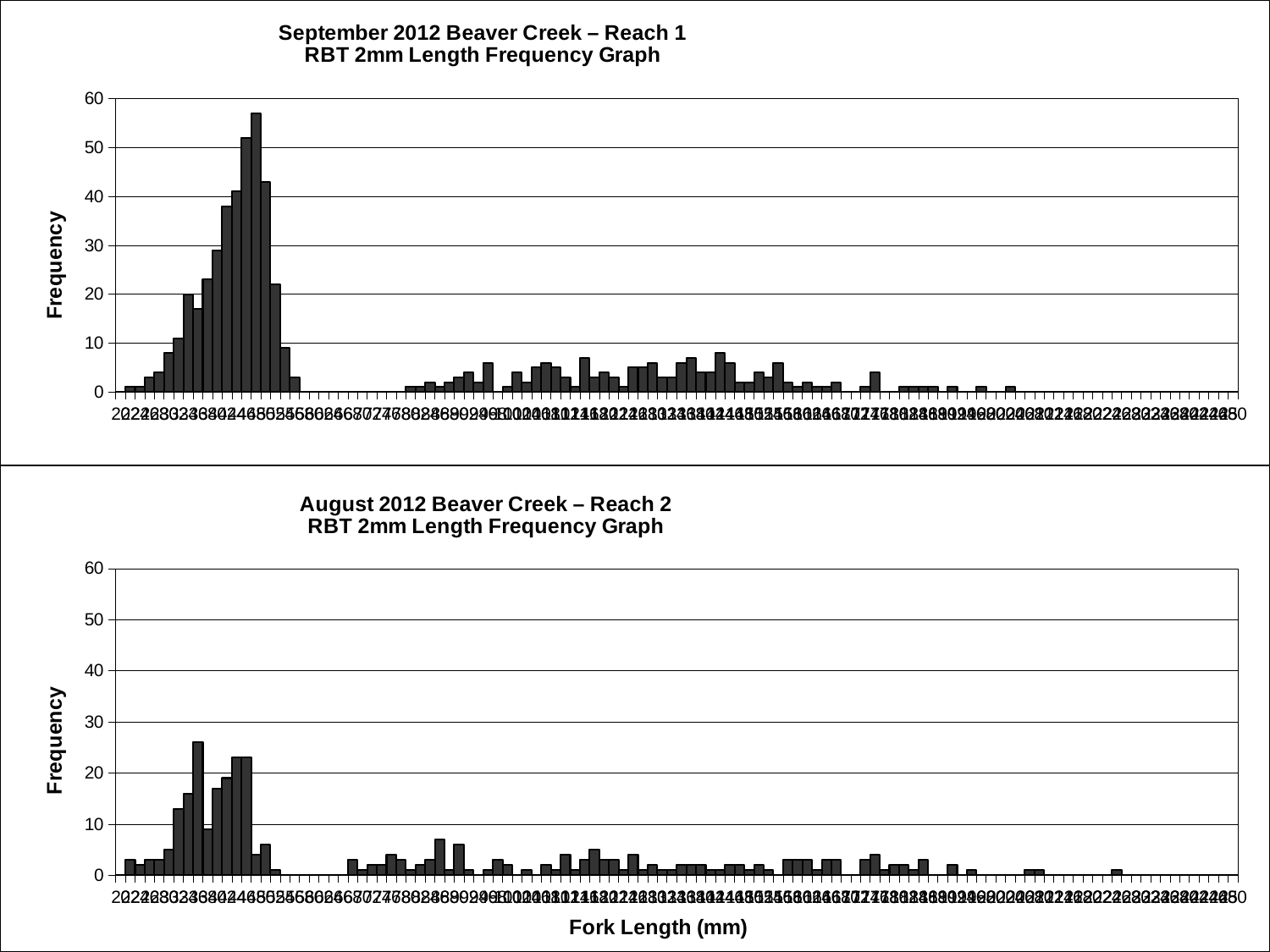
In the top chart (September 2012 Beaver Creek – Reach 1), is the tallest bar greater or less than 50? greater In the bottom chart (August 2012 Beaver Creek – Reach 2), is the tallest bar greater or less than 20? greater What is the label of the x axis on the bottom chart (August 2012 Beaver Creek – Reach 2)? Fork Length (mm) In the bottom chart (August 2012 Beaver Creek – Reach 2), is the tallest bar greater or less than 30? less What kind of chart is the bottom chart, titled "August 2012 Beaver Creek – Reach 2 RBT 2mm Length Frequency Graph"? bar chart What kind of chart is the top chart, titled "September 2012 Beaver Creek – Reach 1 RBT 2mm Length Frequency Graph"? bar chart What is the label of the y axis on the top chart (September 2012 Beaver Creek – Reach 1)? Frequency What is the maximum value shown on the y axis of the bottom chart (August 2012 Beaver Creek – Reach 2)? 60 Which chart has the higher peak frequency, the top chart (September 2012 Reach 1) or the bottom chart (August 2012 Reach 2)? the top chart (September 2012 Reach 1) How many charts are shown on the slide? 2